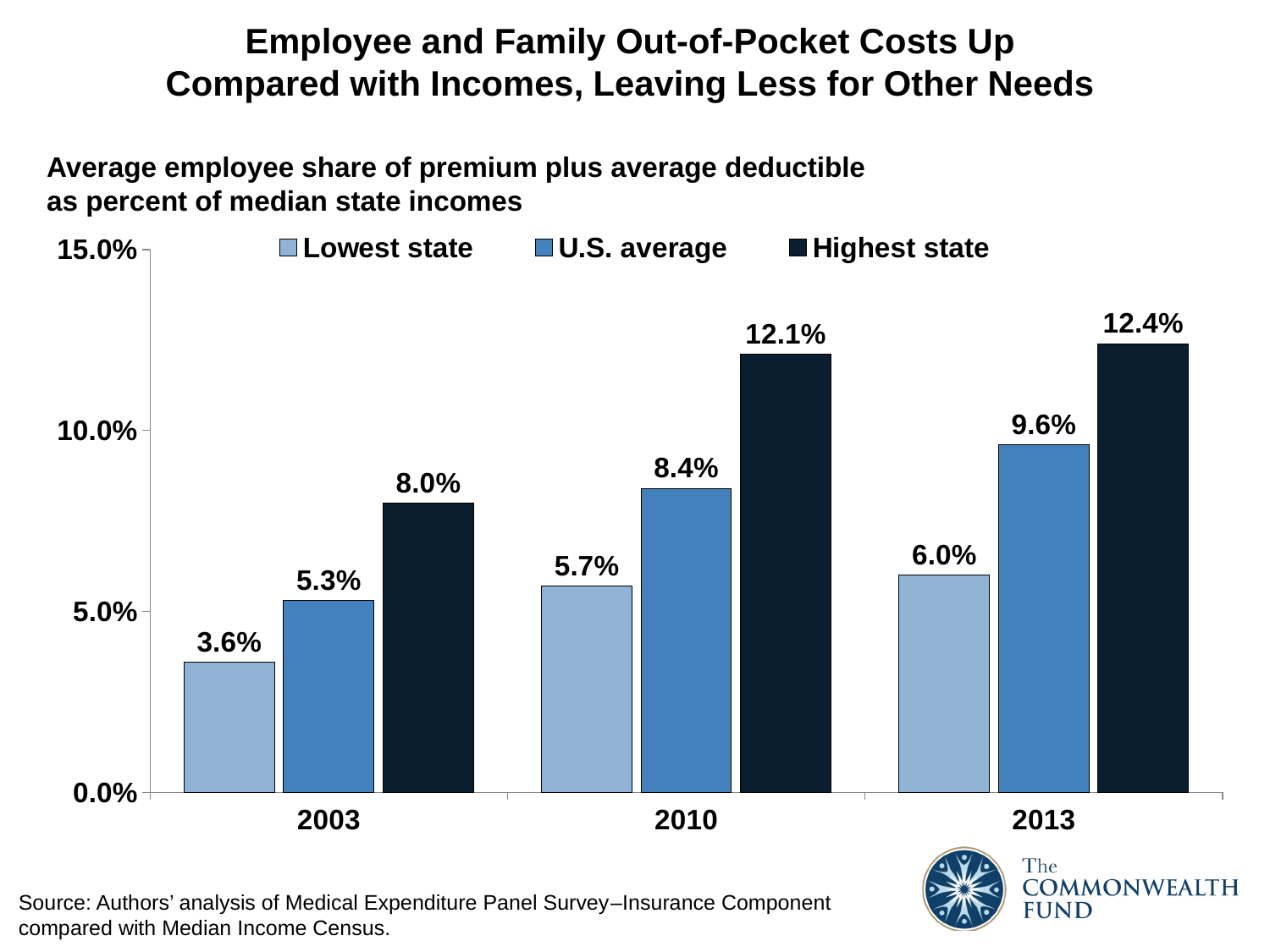
What is the difference between the Highest state and Lowest state values in 2010? 6.4% What is the value for the Highest state in 2013? 12.4% In which year is the U.S. average value highest? 2013 What is the value for the Lowest state in 2003? 3.6% In which year is the Highest state value lowest? 2003 What kind of chart is shown on the slide? Bar chart What is the U.S. average value in 2010? 8.4% By how much did the U.S. average value increase from 2003 to 2013? 4.3% How many series does the legend list? 3 Do the Lowest state values rise or fall from 2003 to 2013? Rise How many years are shown on the x axis? 3 Which is larger: the Highest state value in 2003 or the U.S. average value in 2013? U.S. average value in 2013